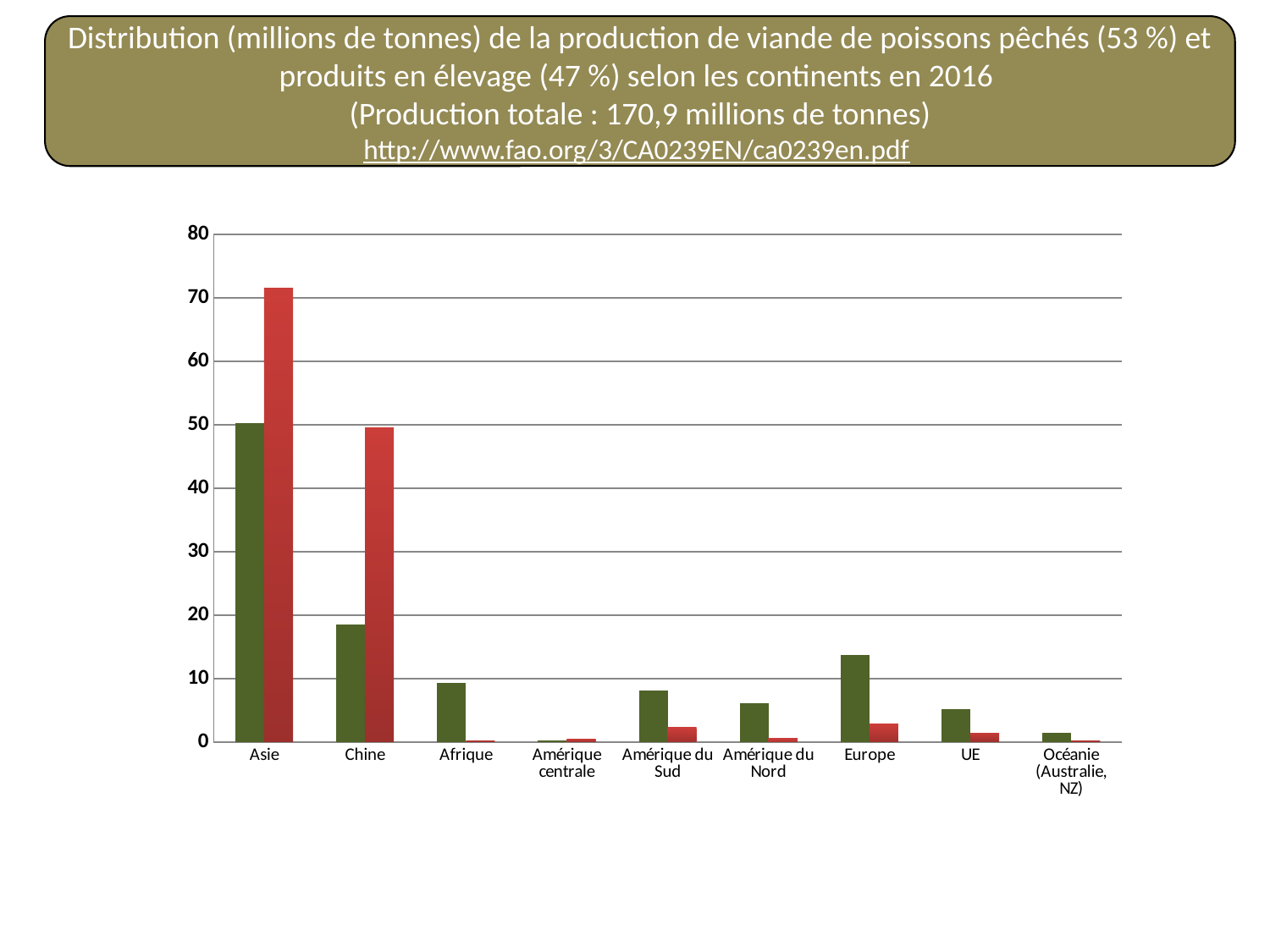
Which category has the tallest red bar? Asie Is the green bar for Chine greater or less than 20? less Is the red bar for Asie greater or less than 70? greater Is the green bar for Europe greater or less than 10? greater Which category has the shortest green bar? Amérique centrale Which category has the tallest green bar? Asie What is the highest value shown on the y axis of the chart? 80 What kind of chart is shown on the slide? bar chart Which has the larger green bar, Europe or UE? Europe Which has the larger green bar, Chine or Europe? Chine How many categories are shown on the x axis of the chart? 9